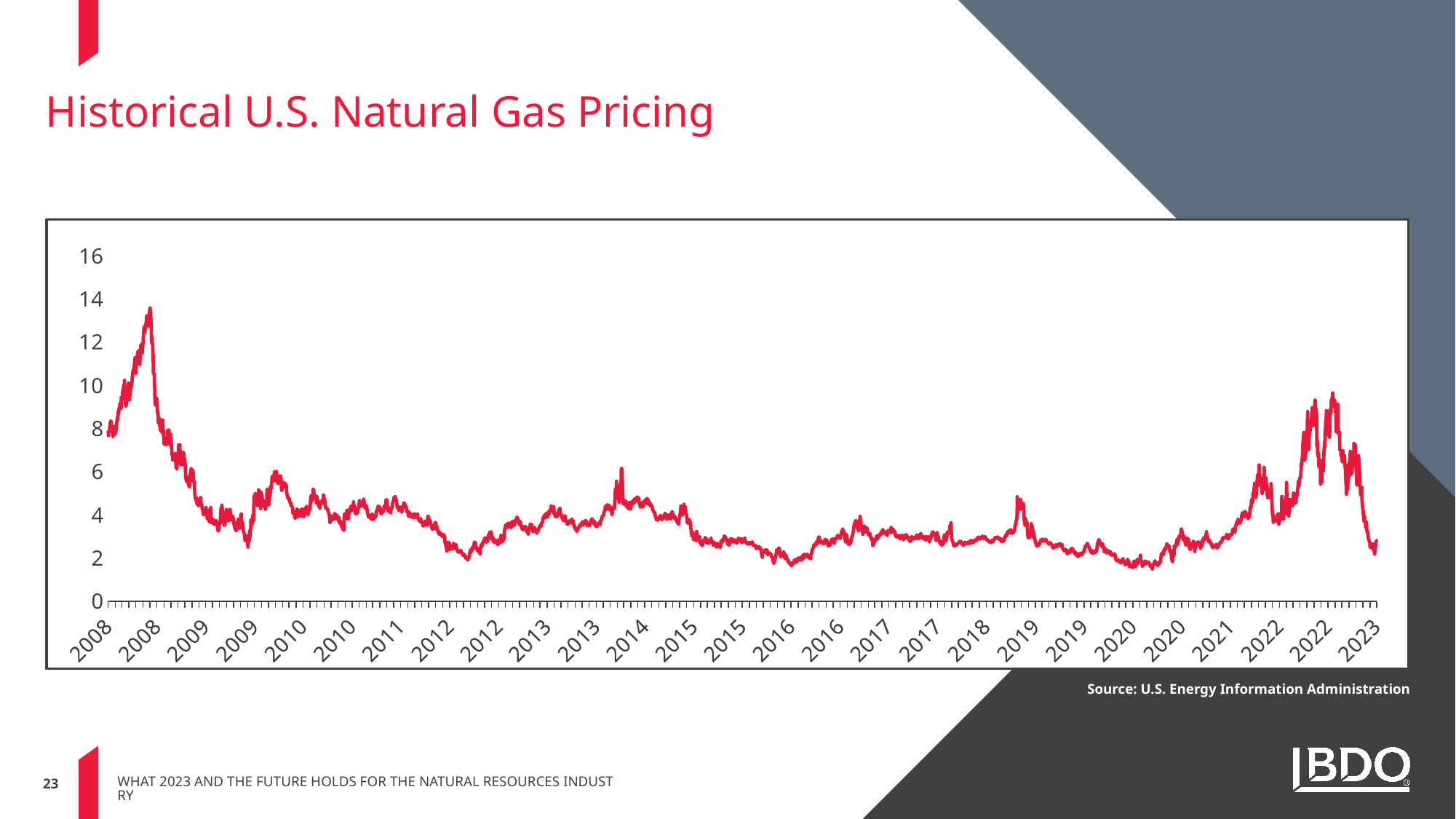
What kind of chart is shown on the slide? line chart In which year does the line reach its highest value? 2008 Is the peak value in 2022 greater or less than 8? greater Is the value at the start of 2008 greater or less than 6? greater Is the peak value in 2022 greater or less than 10? less What source is cited for the chart? U.S. Energy Information Administration Does the line rise or fall from the start of 2008 to the 2008 peak? rise Does the line rise or fall between the 2022 peak and the end of the series in 2023? fall Which is higher, the peak in 2008 or the peak in 2022? the peak in 2008 What is the title of the slide's chart? Historical U.S. Natural Gas Pricing